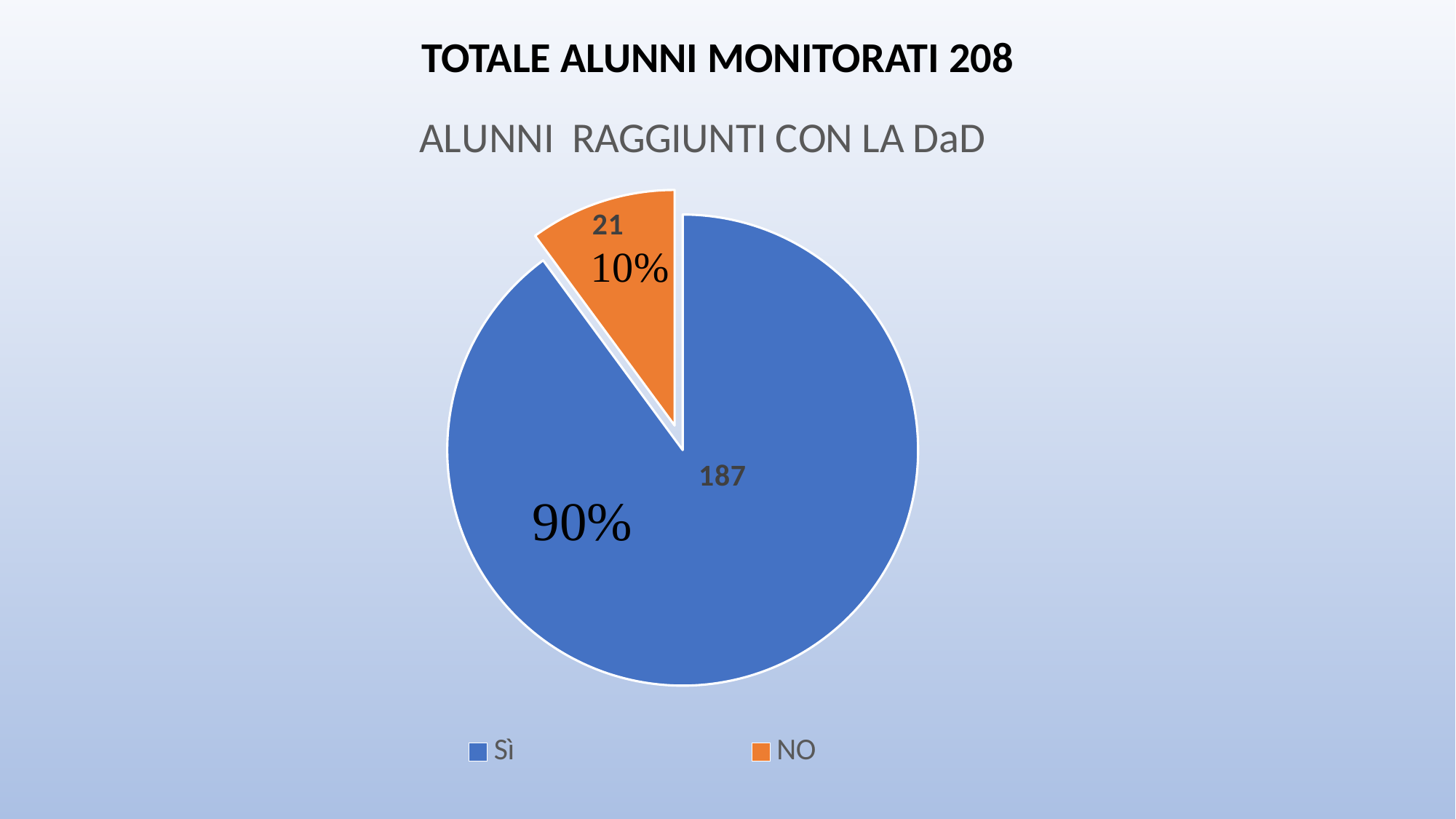
What is the value for NO? 21 Which is larger, the value for Sì or the value for NO? Sì What share of the pie does the Sì slice represent? 90% What kind of chart is shown on the slide? pie chart What is the difference between the values for Sì and NO? 166 Which category has the smallest slice? NO What share of the pie does the NO slice represent? 10% What is the title of the chart? ALUNNI RAGGIUNTI CON LA DaD What is the value for Sì? 187 What is the total of the two slices in the pie chart? 208 How many slices does the pie chart have? 2 Which category has the largest slice? Sì